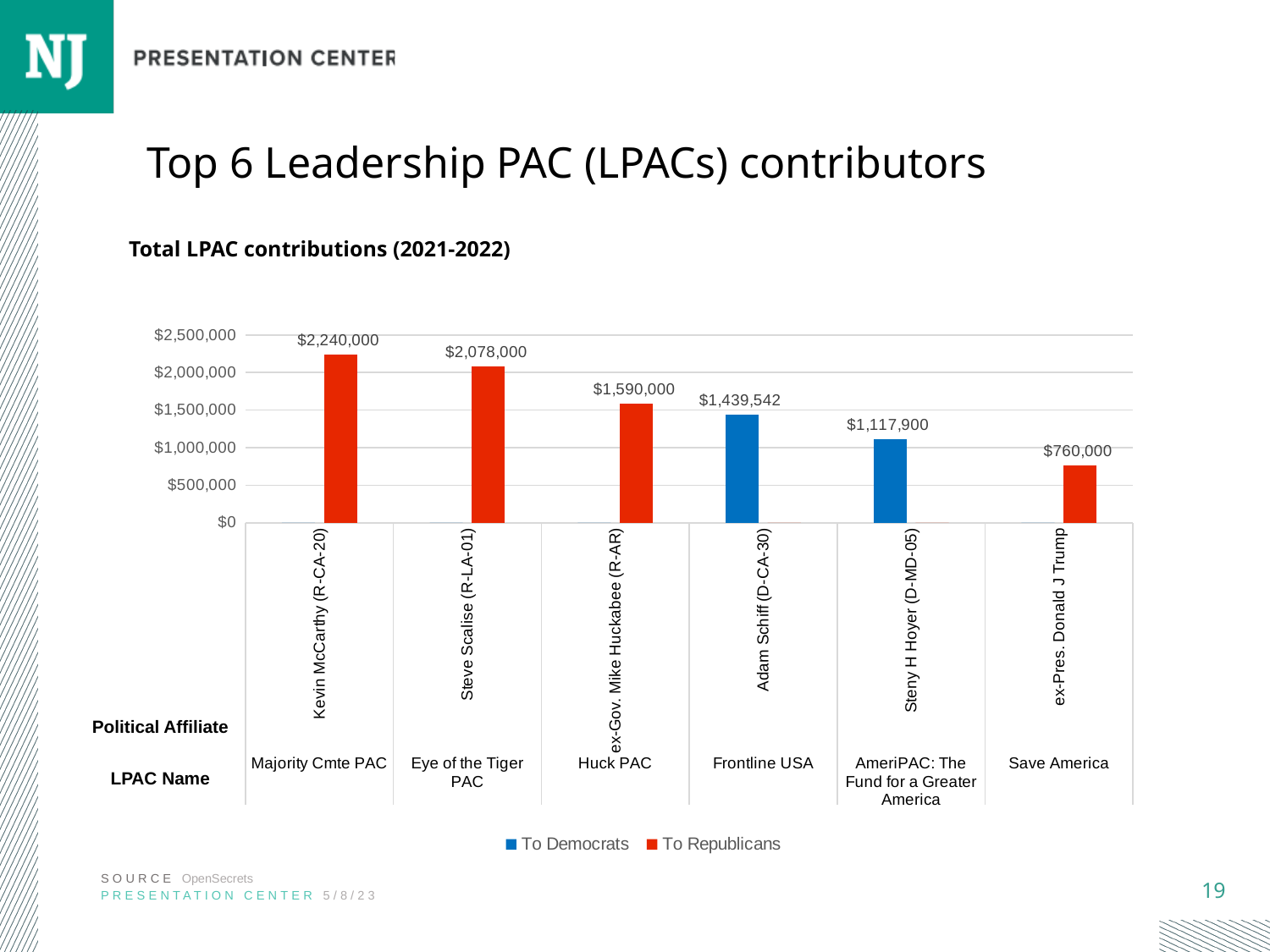
What is the total LPAC contribution shown for AmeriPAC: The Fund for a Greater America? $1,117,900 What is the difference between the contributions of Majority Cmte PAC and Eye of the Tiger PAC? $162,000 Which LPAC has the lowest total contributions in the chart? Save America Which LPAC has the highest total contributions in the chart? Majority Cmte PAC Which has larger total contributions, Huck PAC or Frontline USA? Huck PAC What is the total LPAC contribution shown for Save America? $760,000 What kind of chart is used to show the total LPAC contributions? Bar chart What is the difference between the contributions of Huck PAC and Frontline USA? $150,458 How many series does the legend list? 2 What is the total LPAC contribution shown for Majority Cmte PAC? $2,240,000 What is the total LPAC contribution shown for Frontline USA? $1,439,542 How many LPACs are shown in the chart? 6